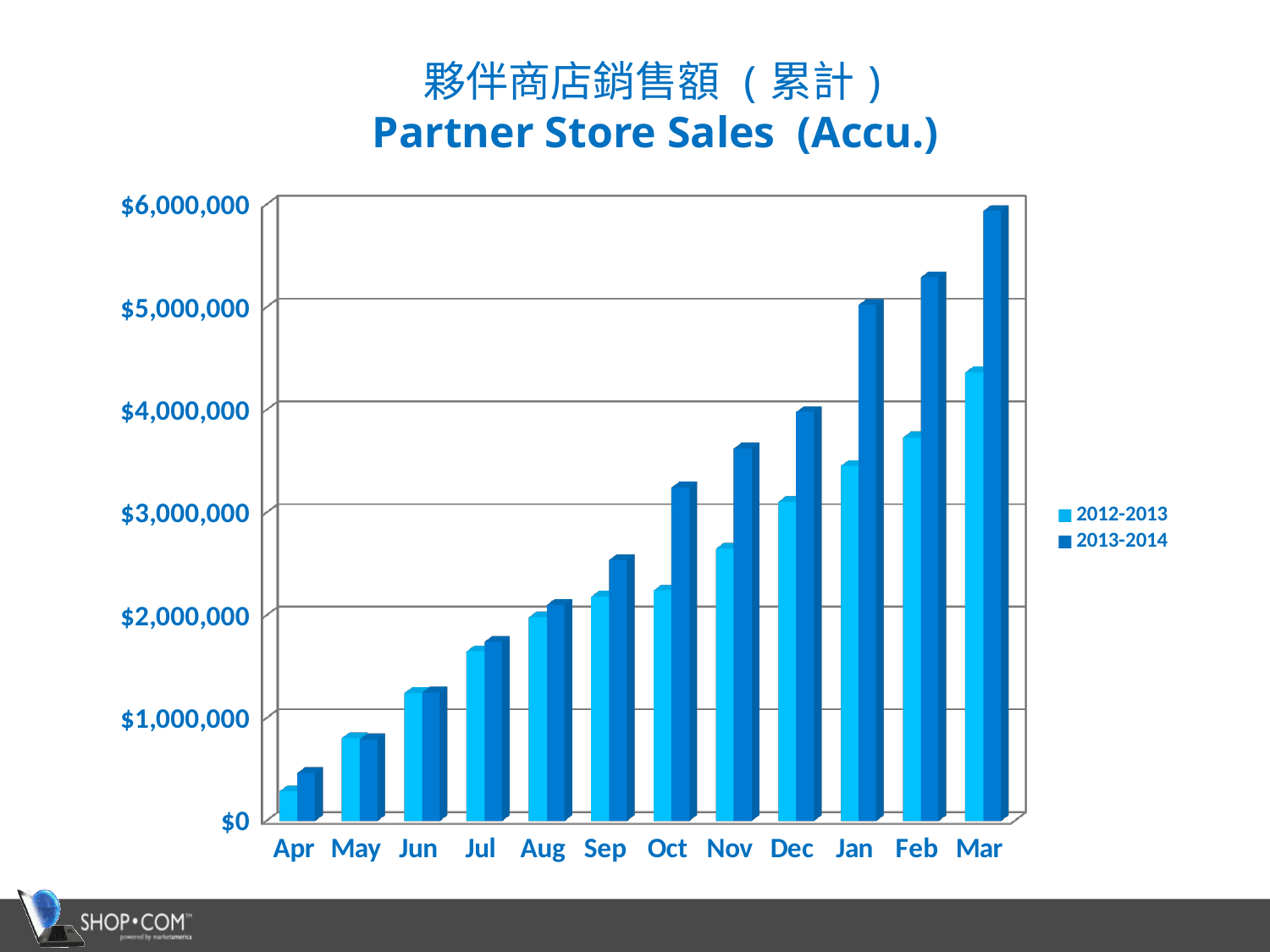
Which month has the highest value for the 2013-2014 series? Mar Which month has the lowest value for the 2012-2013 series? Apr Do the 2013-2014 values rise or fall from Apr to Mar? rise Is the 2012-2013 value for Nov greater or less than $3,000,000? less For Jan, which series has the larger value, 2012-2013 or 2013-2014? 2013-2014 How many series does the legend list? 2 Is the 2012-2013 value for Apr greater or less than $1,000,000? less Is the 2013-2014 value for Mar greater or less than $5,000,000? greater What kind of chart is shown on the slide? bar chart How many months are shown on the x axis? 12